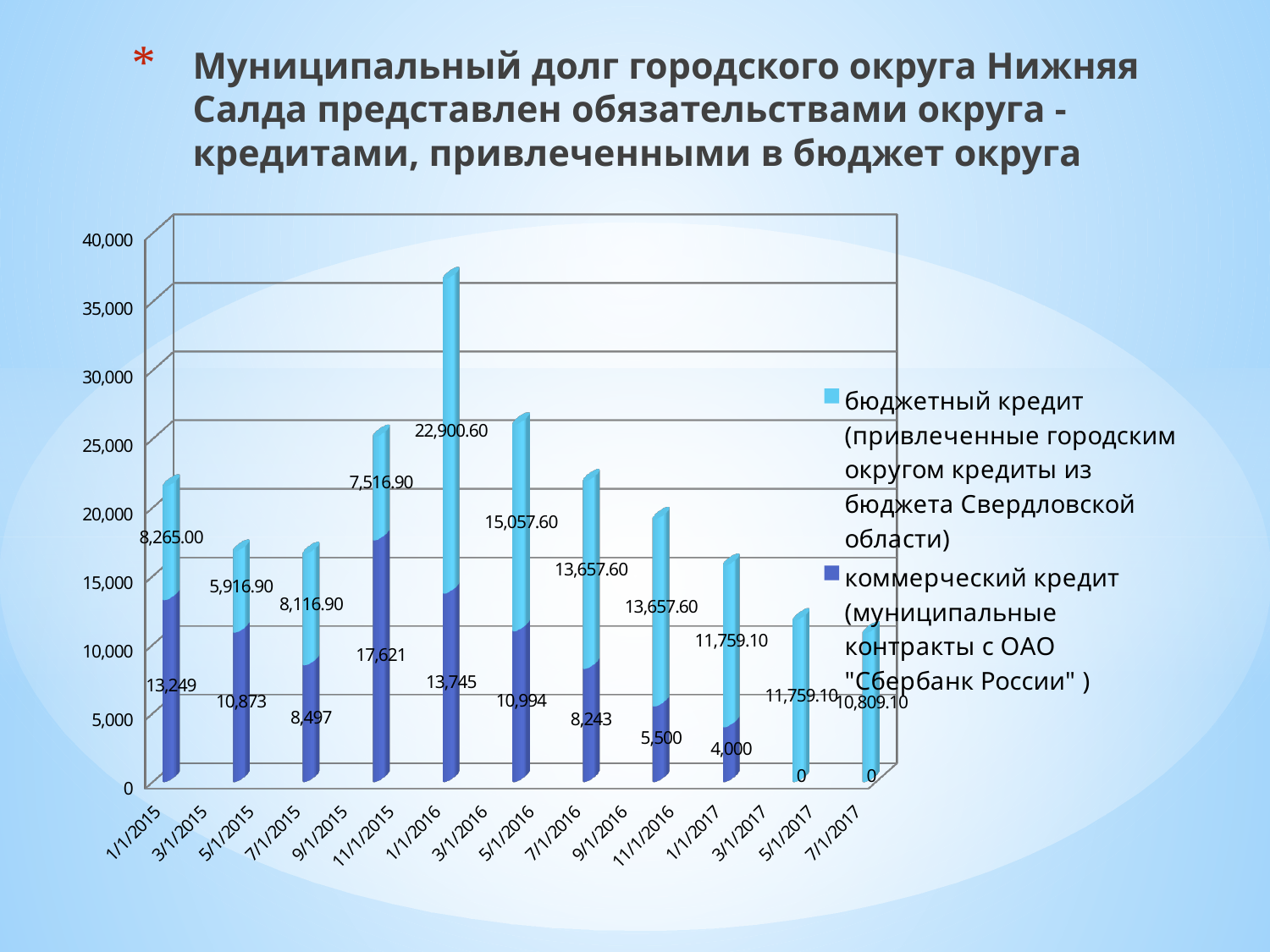
What is the value of the коммерческий кредит segment in the first (leftmost) bar? 13,249 What is the difference between the бюджетный кредит values 22,900.60 and 15,057.60 in the fifth and sixth bars? 7,843.00 What is the highest value labelled for the бюджетный кредит series? 22,900.60 What is the total of the tallest stacked bar (коммерческий кредит 13,745 plus бюджетный кредит 22,900.60)? 36,645.60 How many series does the legend list? 2 In the first (leftmost) bar, which segment is larger: коммерческий кредит or бюджетный кредит? коммерческий кредит What is the value of the бюджетный кредит segment in the last (rightmost) bar? 10,809.10 How many stacked bars are plotted in the chart? 11 What kind of chart is shown on the slide? bar chart What is the value of the коммерческий кредит segment in the rightmost bar? 0 What is the highest value labelled for the коммерческий кредит series? 17,621 Does the коммерческий кредит series generally rise or fall from the fourth bar to the last bar? fall